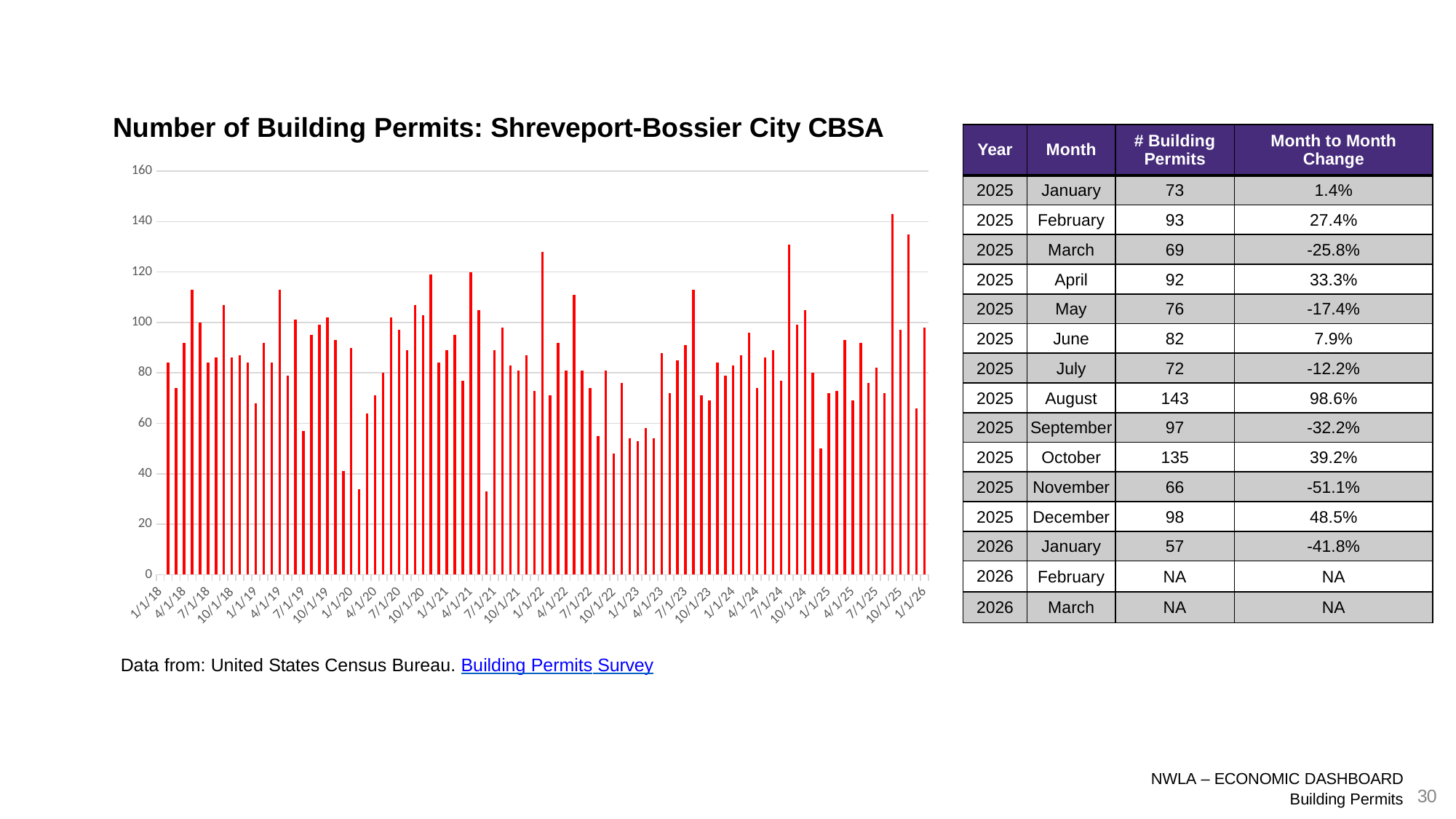
What is the difference in building permits between August 2025 and September 2025? 46 What kind of chart is shown on the slide? bar chart Is the value for the tallest bar in the chart greater or less than 140? greater What is the number of building permits for October 2025? 135 What is the number of building permits for August 2025? 143 Which month had more building permits, February 2025 or March 2025? February 2025 What is the number of building permits for January 2026? 57 What is the title of the chart? Number of Building Permits: Shreveport-Bossier City CBSA Which month has the highest number of building permits in the chart? August 2025 What is the highest value shown on the chart's vertical axis? 160 What is the difference in building permits between October 2025 and November 2025? 69 Is the value for the first bar (1/1/18) greater or less than 100? less